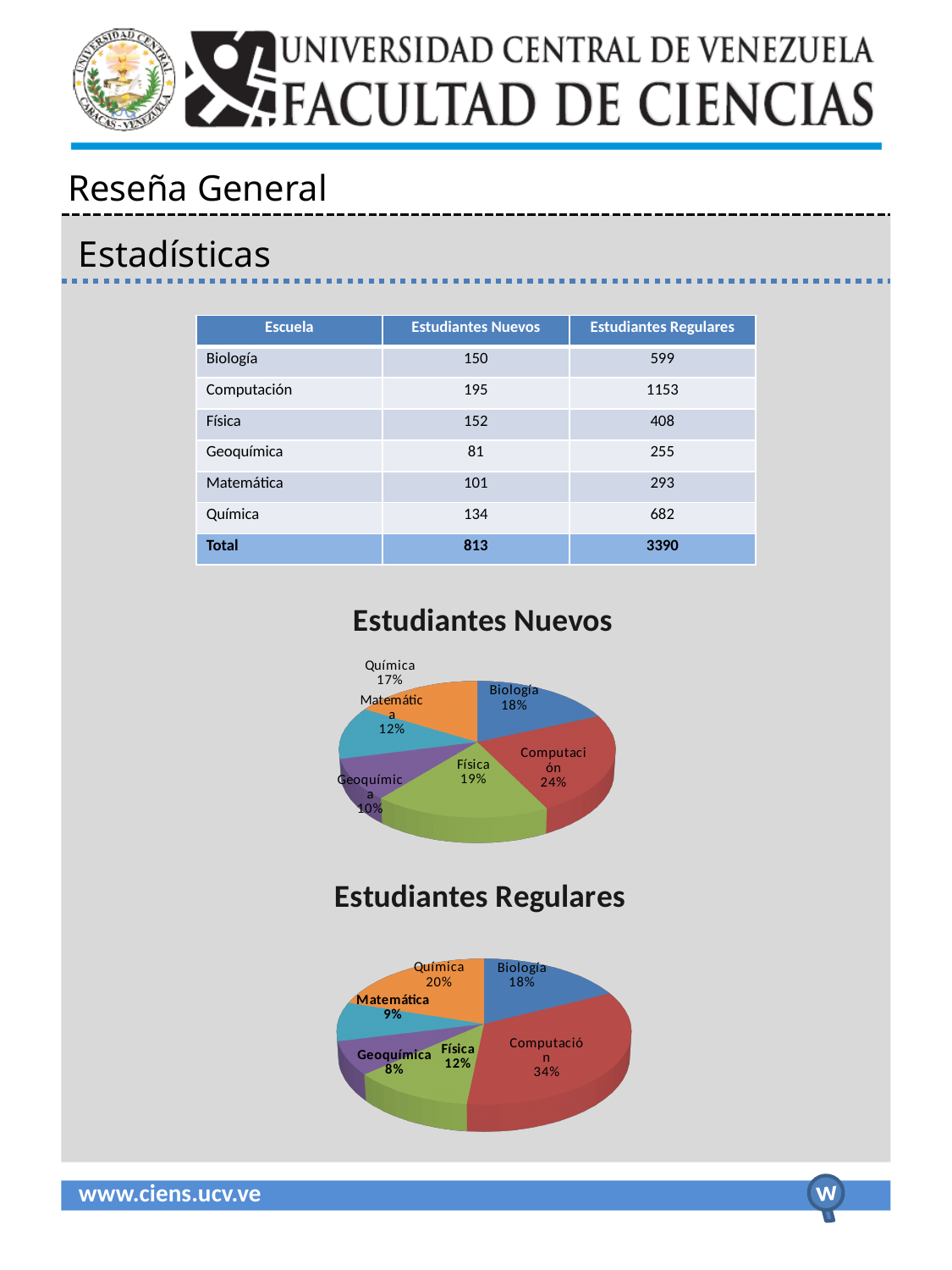
What kind of chart is Estudiantes Regulares? Pie chart In the Estudiantes Nuevos chart, how many slices does the pie have? 6 In the Estudiantes Regulares chart, which is larger, the Química slice or the Física slice? Química In the Estudiantes Nuevos chart, what share does Geoquímica have? 10% In the Estudiantes Regulares chart, what share does Computación have? 34% What is the title of the upper pie chart? Estudiantes Nuevos In the Estudiantes Nuevos chart, what share does Computación have? 24% In the Estudiantes Nuevos chart, which school has the smallest slice? Geoquímica In the Estudiantes Nuevos chart, which school has the largest slice? Computación In the Estudiantes Regulares chart, what is the difference in percentage points between Computación and Biología? 16 In the Estudiantes Regulares chart, which school has the smallest slice? Geoquímica